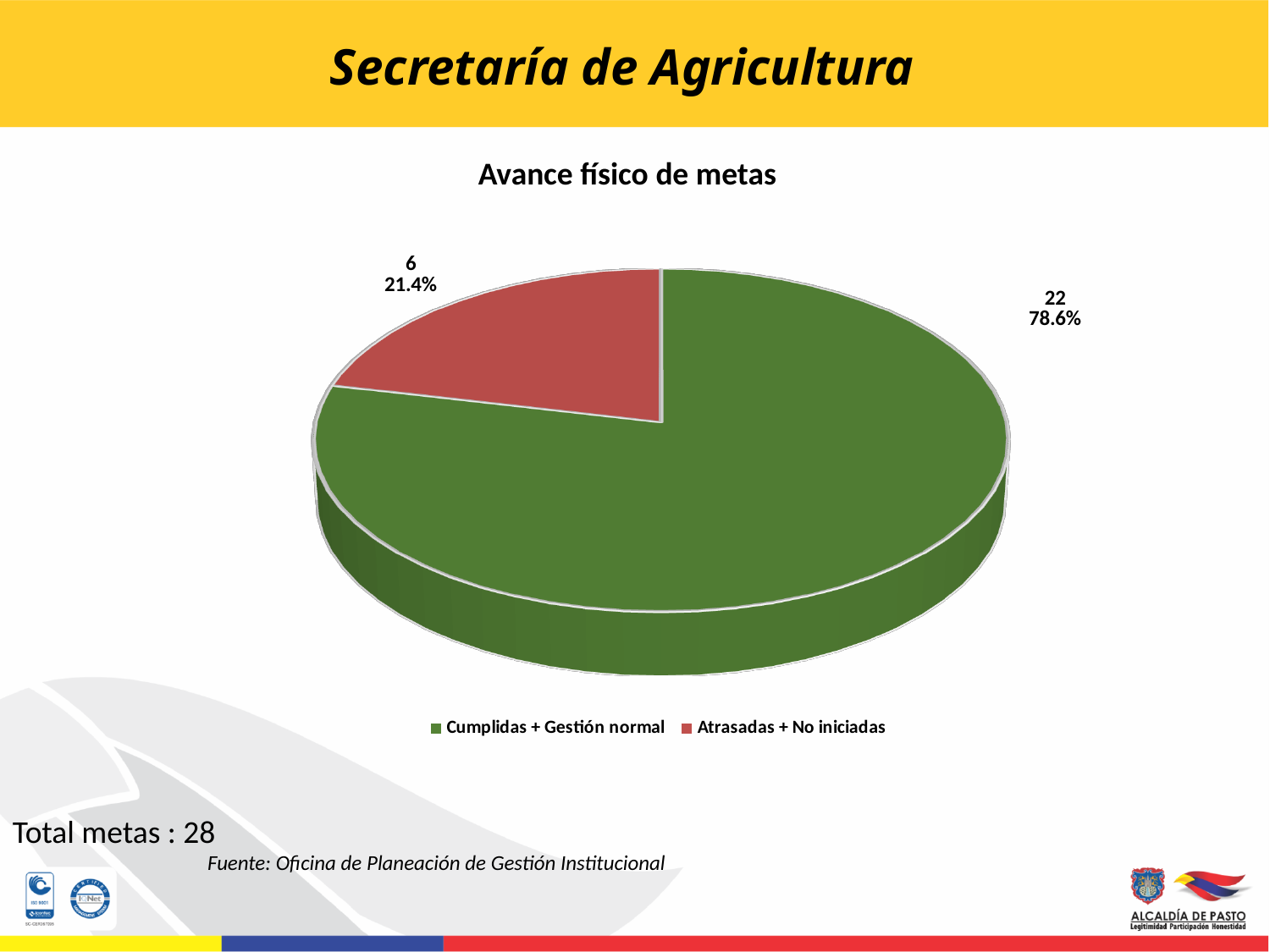
What share of the pie does Atrasadas + No iniciadas represent? 21.4% What kind of chart is shown on the slide? pie chart Which category has the largest slice? Cumplidas + Gestión normal Which colour represents Atrasadas + No iniciadas in the chart? red How many entries does the legend list? 2 What is the difference between the values for Cumplidas + Gestión normal and Atrasadas + No iniciadas? 16 Which category has the smallest slice? Atrasadas + No iniciadas How many slices does the pie chart have? 2 What is the value for Atrasadas + No iniciadas? 6 What is the title of the chart? Avance físico de metas What share of the pie does Cumplidas + Gestión normal represent? 78.6% What is the value for Cumplidas + Gestión normal? 22